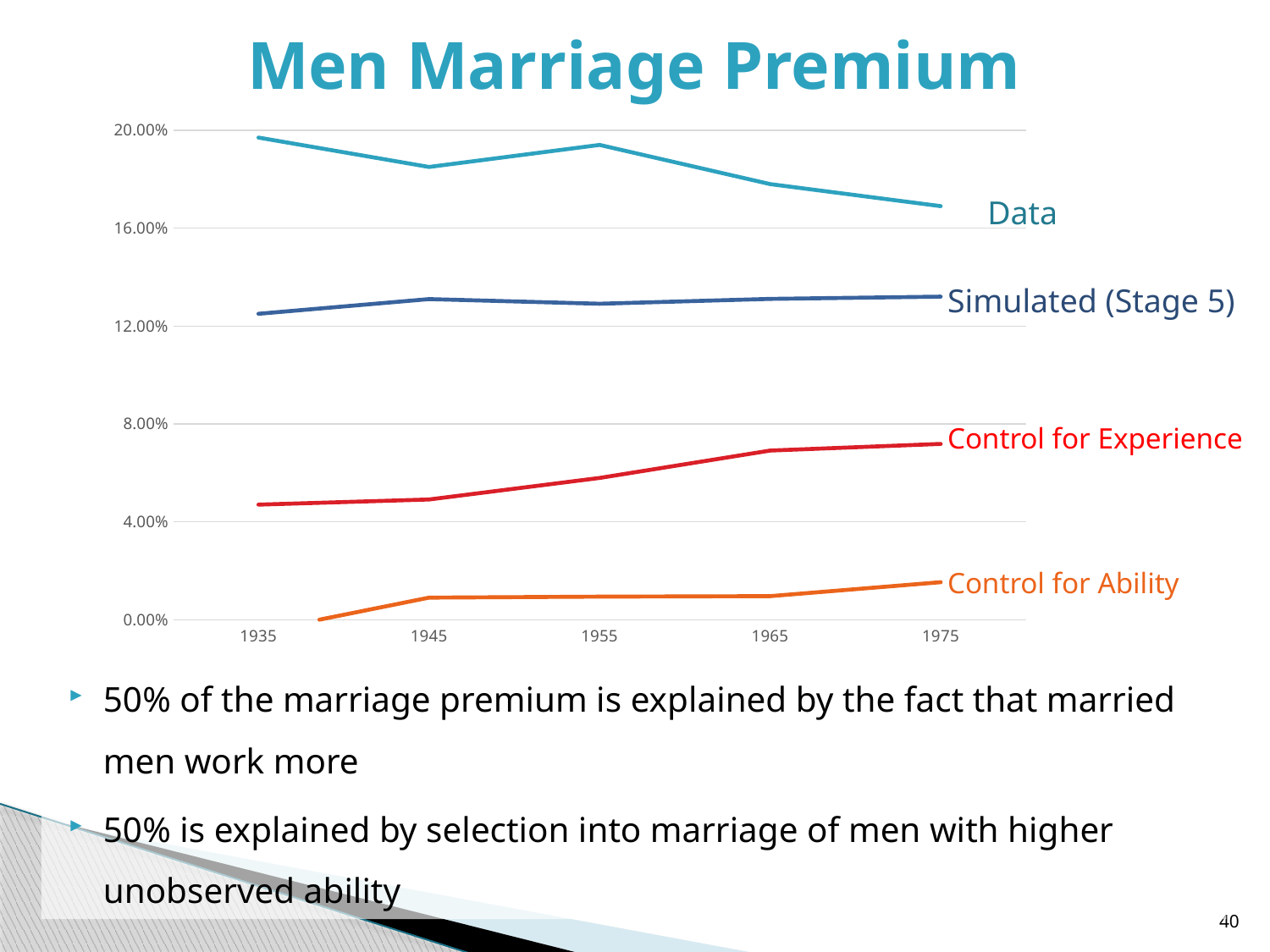
Is the value of the Control for Ability series at 1975 greater or less than 4.00%? less What kind of chart is shown on the slide? line chart Which series has the highest value at 1935? Data Is the value of the Data series at 1935 greater or less than 16.00%? greater Does the Data series rise or fall overall from 1935 to 1975? fall How many series are plotted on the chart? 4 Is the value of the Simulated (Stage 5) series at 1975 greater or less than 12.00%? greater Does the Control for Experience series rise or fall from 1935 to 1975? rise At 1975, which is larger: the Data series or the Simulated (Stage 5) series? Data Which series has the lowest value at 1975? Control for Ability How many year labels are shown on the x axis? 5